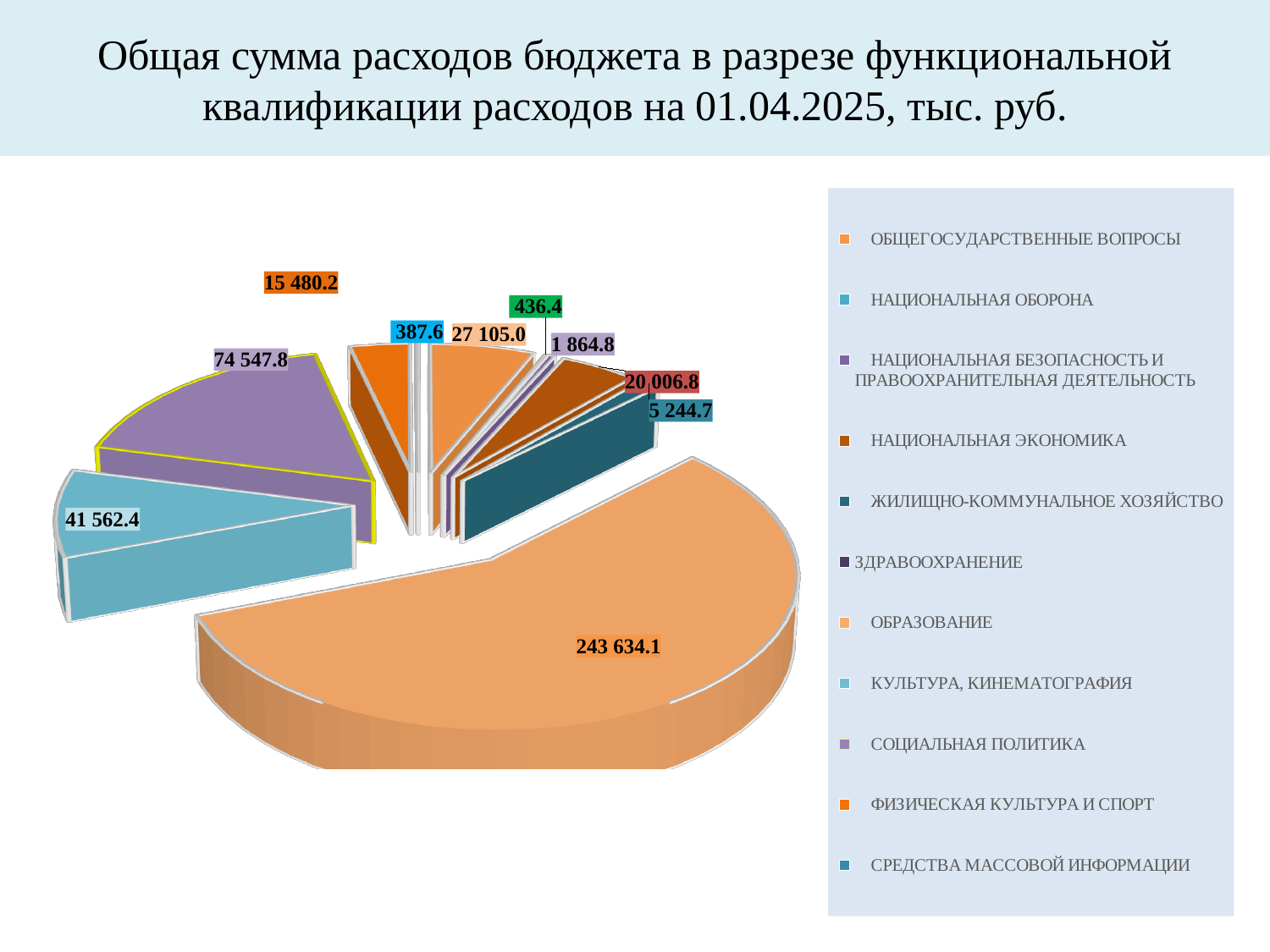
How many categories does the legend of the pie chart list? 11 What is the smallest value shown on the pie chart? 387.6 In what units are the values on the chart expressed, according to the slide title? тыс. руб. Which is larger, the value for СОЦИАЛЬНАЯ ПОЛИТИКА or the value for КУЛЬТУРА, КИНЕМАТОГРАФИЯ? СОЦИАЛЬНАЯ ПОЛИТИКА How many slices with data labels does the pie chart have? 10 What kind of chart is shown on the slide? pie chart What is the value of the largest slice in the pie chart? 243 634.1 What is the value for СОЦИАЛЬНАЯ ПОЛИТИКА? 74 547.8 Which category has the largest slice in the pie chart? ОБРАЗОВАНИЕ What is the difference between the values for СОЦИАЛЬНАЯ ПОЛИТИКА (74 547.8) and КУЛЬТУРА, КИНЕМАТОГРАФИЯ (41 562.4)? 32 985.4 What is the value for КУЛЬТУРА, КИНЕМАТОГРАФИЯ? 41 562.4 What is the value for ФИЗИЧЕСКАЯ КУЛЬТУРА И СПОРТ? 15 480.2